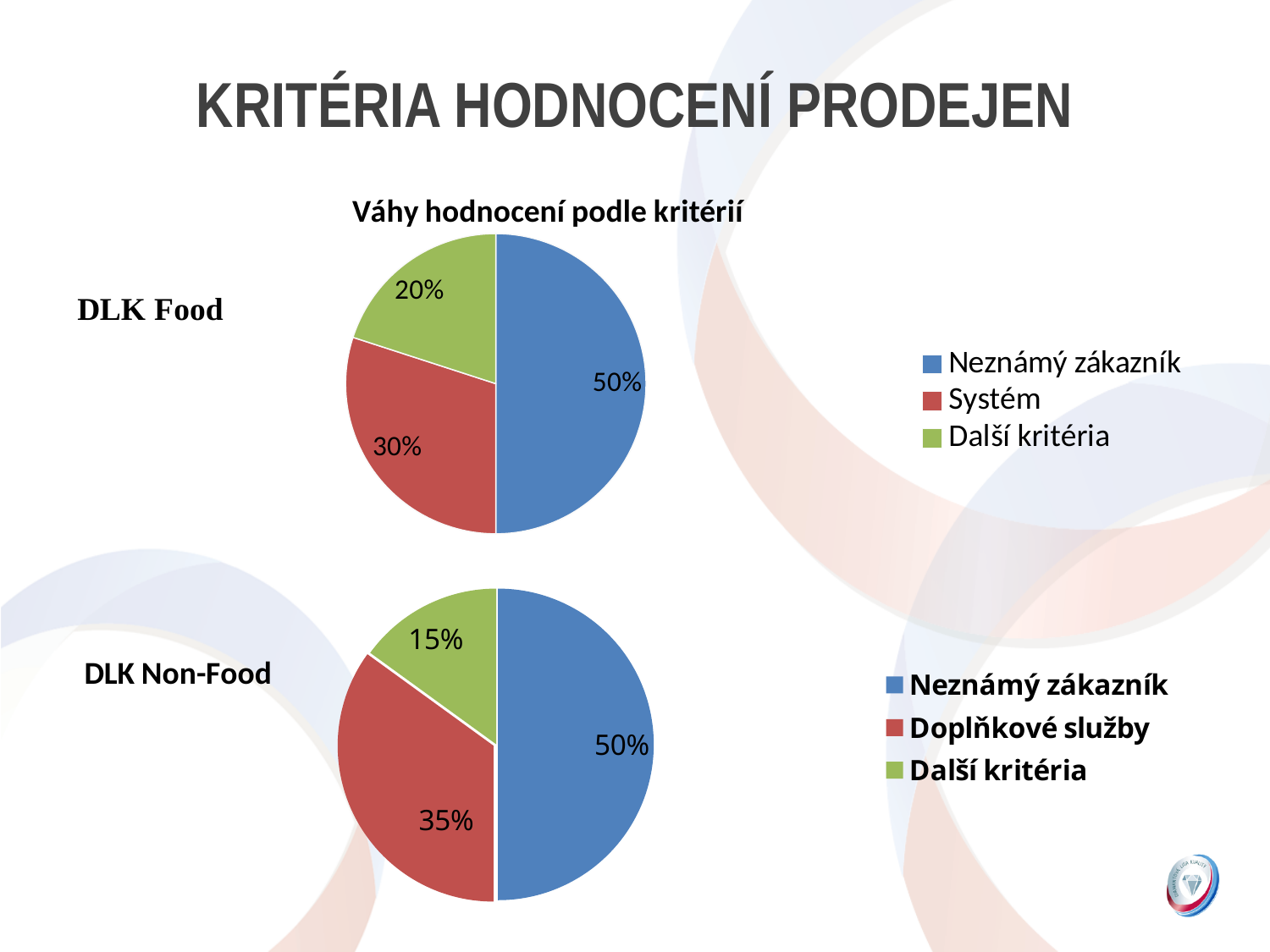
In the DLK Non-Food pie chart, what is the difference between the shares of Doplňkové služby and Další kritéria? 20% In the DLK Food pie chart, which category has the largest share? Neznámý zákazník In the DLK Food pie chart, what is the difference between the shares of Neznámý zákazník and Systém? 20% In the DLK Food pie chart, what share does Systém have? 30% How many slices does the DLK Non-Food pie chart have? 3 Which is larger: the share of Další kritéria in the DLK Food chart or in the DLK Non-Food chart? DLK Food In the DLK Non-Food pie chart, which category has the smallest share? Další kritéria In the DLK Non-Food pie chart, what share does Další kritéria have? 15% In the DLK Food pie chart, what share does Další kritéria have? 20% What is the title shown above the DLK Food chart? Váhy hodnocení podle kritérií In the DLK Non-Food pie chart, what share does Doplňkové služby have? 35% What type of chart is used for DLK Food? Pie chart